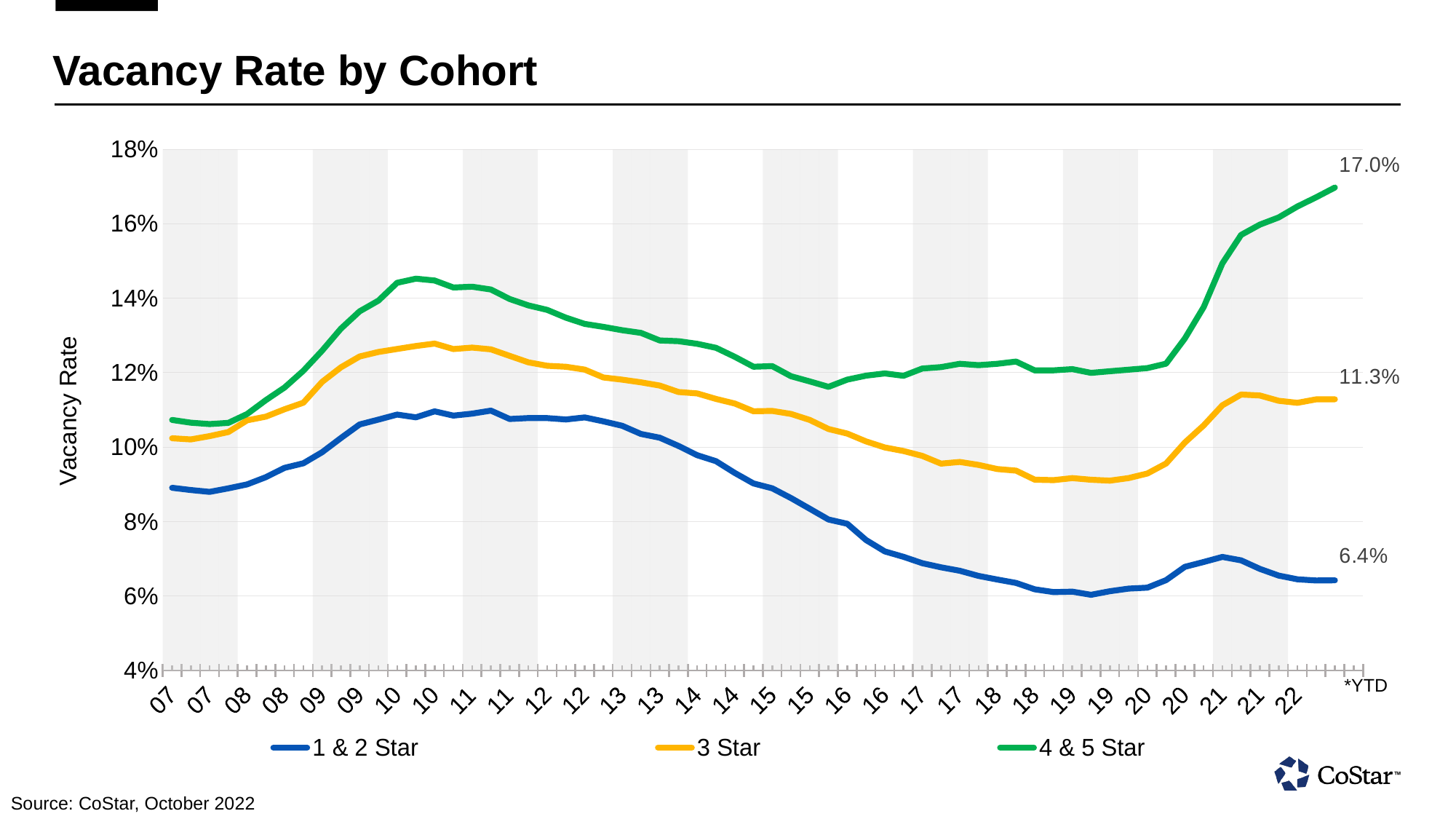
What is the difference between the latest 4 & 5 Star and 3 Star vacancy rates? 5.7% What is the difference between the latest 3 Star and 1 & 2 Star vacancy rates? 4.9% Which cohort has the lowest vacancy rate at the end of the series? 1 & 2 Star Is the 1 & 2 Star vacancy rate in 2019 greater or less than 8%? less What is the latest (YTD) vacancy rate for the 1 & 2 Star cohort? 6.4% What is the latest (YTD) vacancy rate for the 4 & 5 Star cohort? 17.0% What is the latest (YTD) vacancy rate for the 3 Star cohort? 11.3% Does the 4 & 5 Star vacancy rate rise or fall between 2020 and 2022? rise How many series does the legend list? 3 Which cohort has the highest vacancy rate at the end of the series? 4 & 5 Star What type of chart is shown on the slide? Line chart What is the title of the chart? Vacancy Rate by Cohort